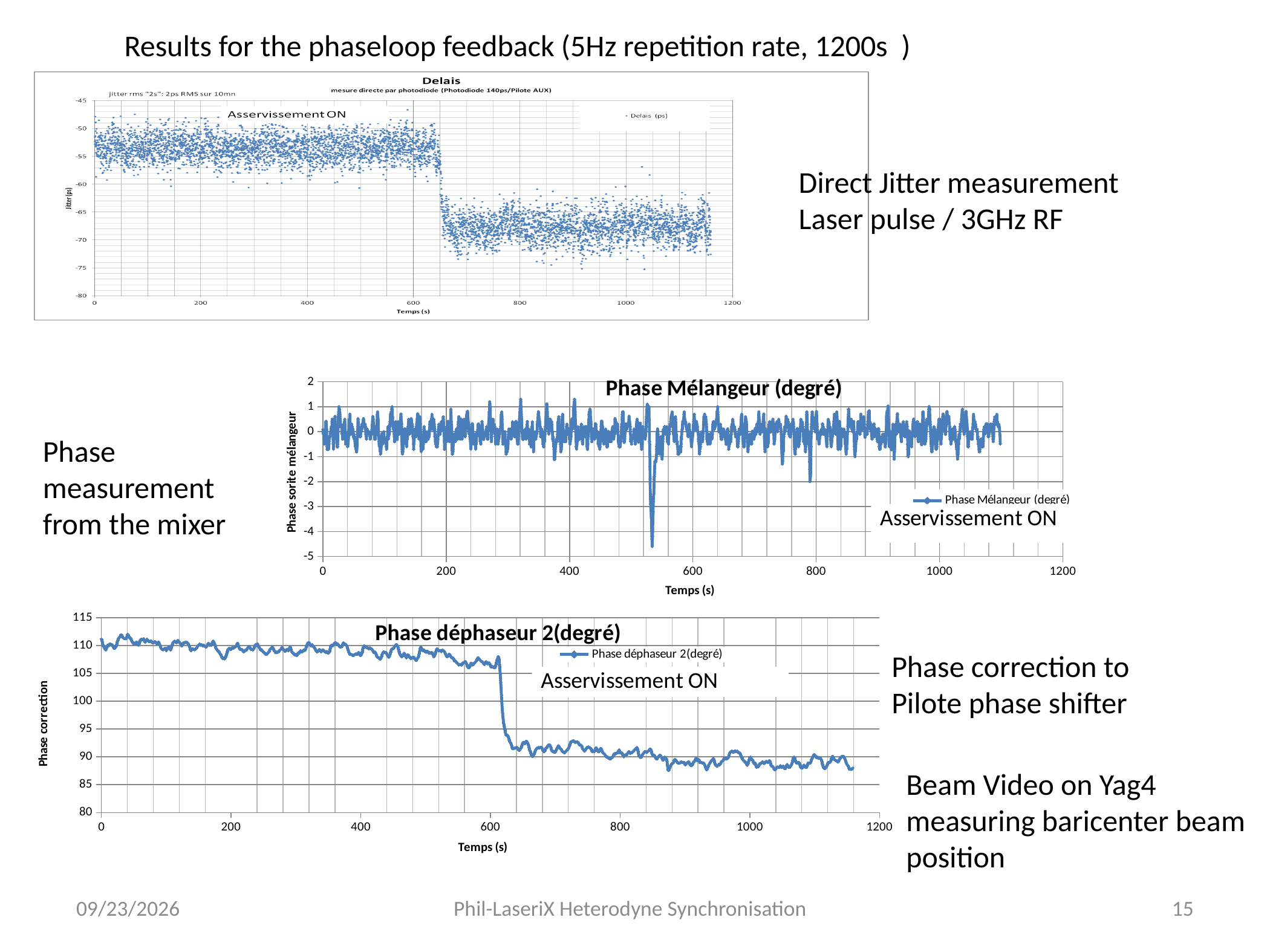
What is the x-axis title of the "Phase déphaseur 2(degré)" chart? Temps (s) In the "Delais" chart, is the value at 200 s greater or less than -60? greater In the "Delais" chart, do the values overall rise or fall from left to right along the x axis? fall In the "Phase déphaseur 2(degré)" chart, is the value at 200 s greater or less than 105? greater How many series does the legend of the "Delais" chart list? 1 What kind of chart is the "Phase déphaseur 2(degré)" chart at the bottom of the slide? line chart In the "Phase déphaseur 2(degré)" chart, do the values overall rise or fall from left to right along the x axis? fall In the "Phase déphaseur 2(degré)" chart, is the value at 1000 s greater or less than 100? less What kind of chart is the "Delais" chart at the top of the slide? scatter chart What is the y-axis title of the "Phase déphaseur 2(degré)" chart? Phase correction How many series does the legend of the "Phase Mélangeur (degré)" chart list? 1